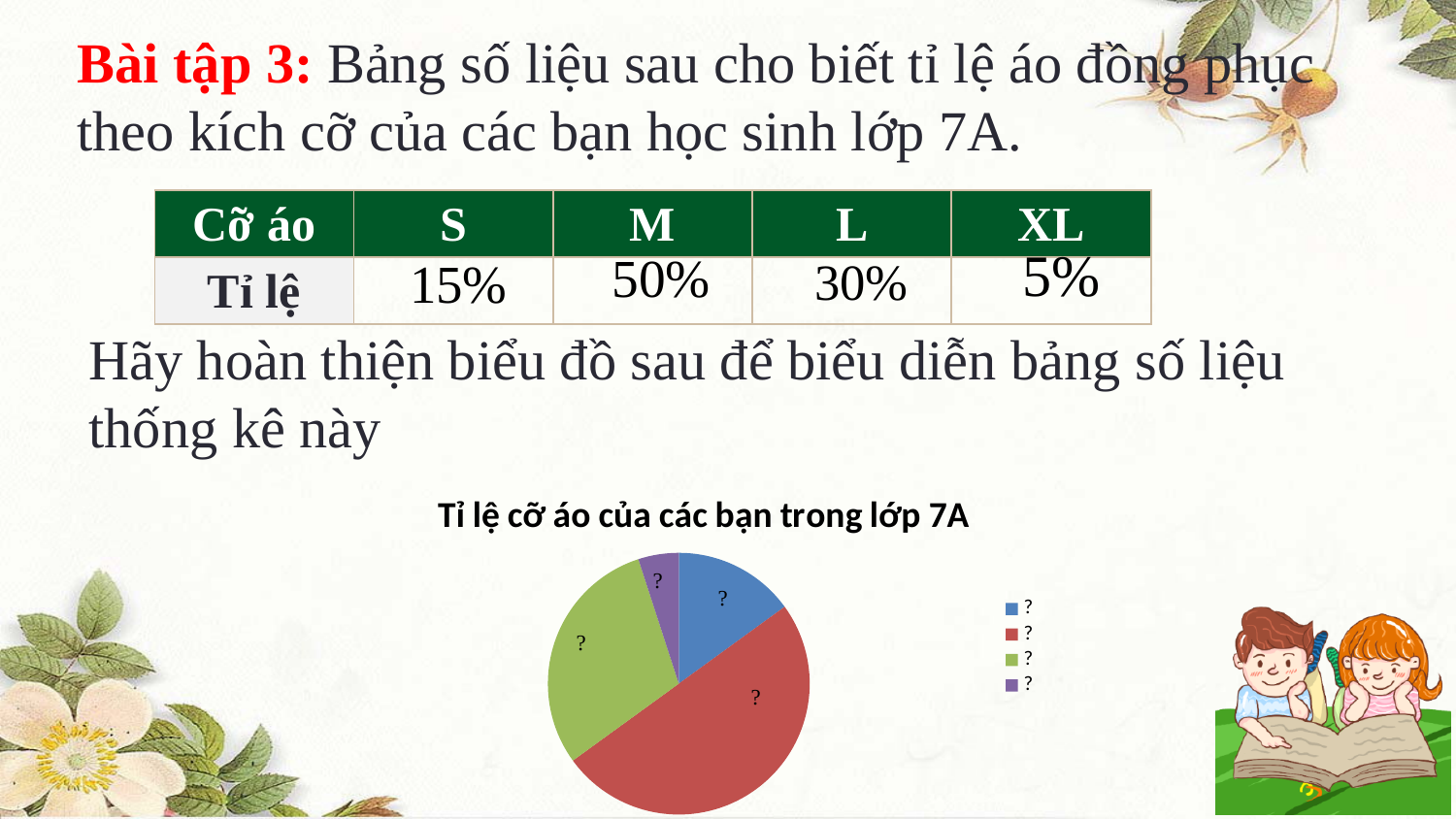
Which slice is larger, the red slice or the blue slice? red Which slice is larger, the blue slice or the green slice? green What kind of chart is shown on the slide? pie chart How many entries does the chart's legend list? 4 Which coloured slice of the pie chart is the smallest? purple What text is shown as the data label on each slice of the pie chart? ? What is the title of the chart? Tỉ lệ cỡ áo của các bạn trong lớp 7A How many slices does the pie chart have? 4 Which coloured slice of the pie chart is the largest? red